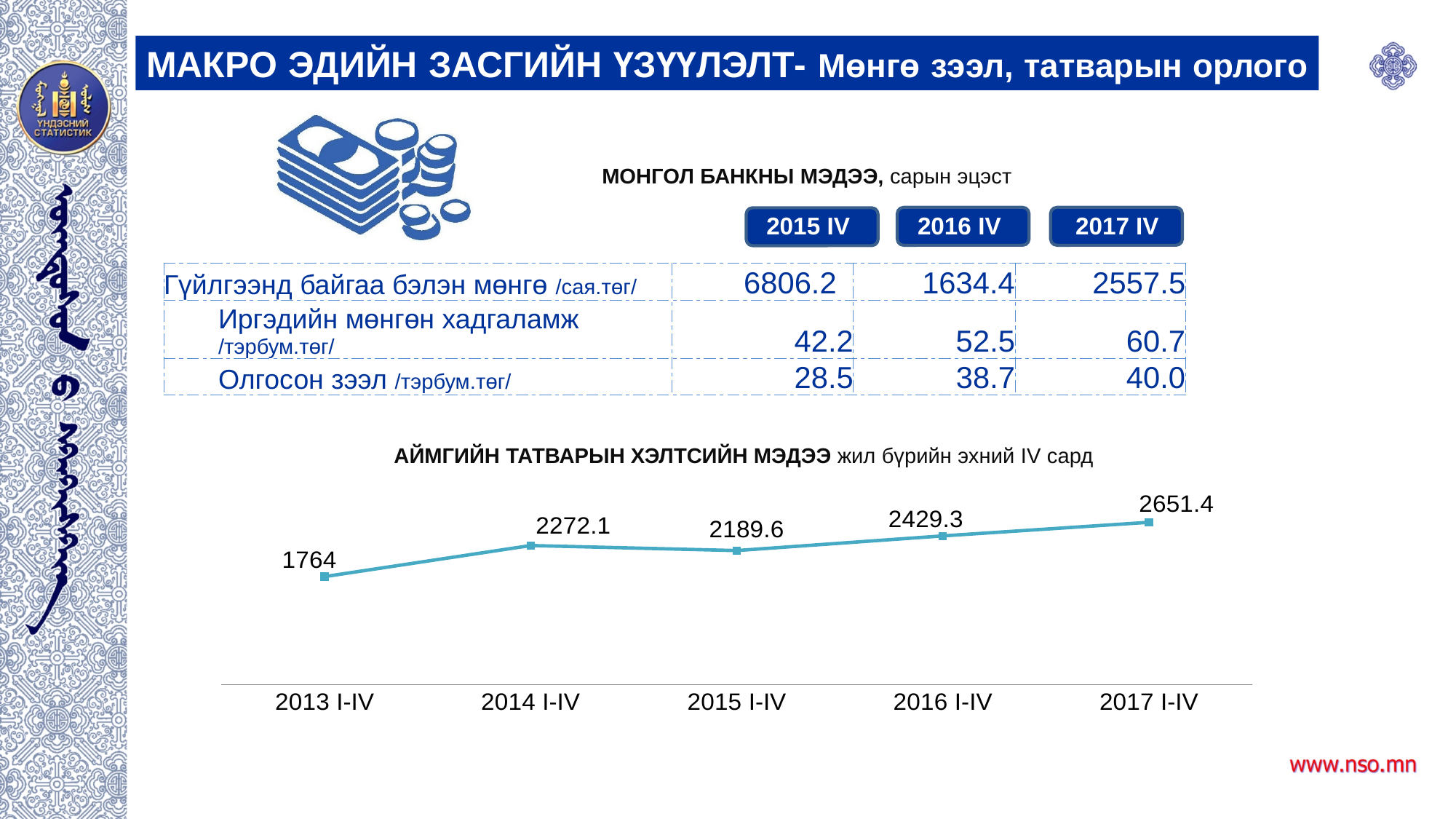
What is the value for 2017 I-IV in the line chart? 2651.4 Does the value in the line chart rise or fall from 2013 I-IV to 2017 I-IV overall? rise What is the value for 2014 I-IV in the line chart? 2272.1 Which period has the highest value in the line chart? 2017 I-IV What is the value for 2013 I-IV in the line chart? 1764 What is the value for 2015 I-IV in the line chart? 2189.6 Which is larger in the line chart, the value for 2014 I-IV or 2015 I-IV? 2014 I-IV What type of chart is shown on the slide? line chart What is the title of the line chart? АЙМГИЙН ТАТВАРЫН ХЭЛТСИЙН МЭДЭЭ жил бүрийн эхний IV сард What is the difference between the values for 2017 I-IV and 2016 I-IV in the line chart? 222.1 Which period has the lowest value in the line chart? 2013 I-IV How many data points are plotted in the line chart? 5